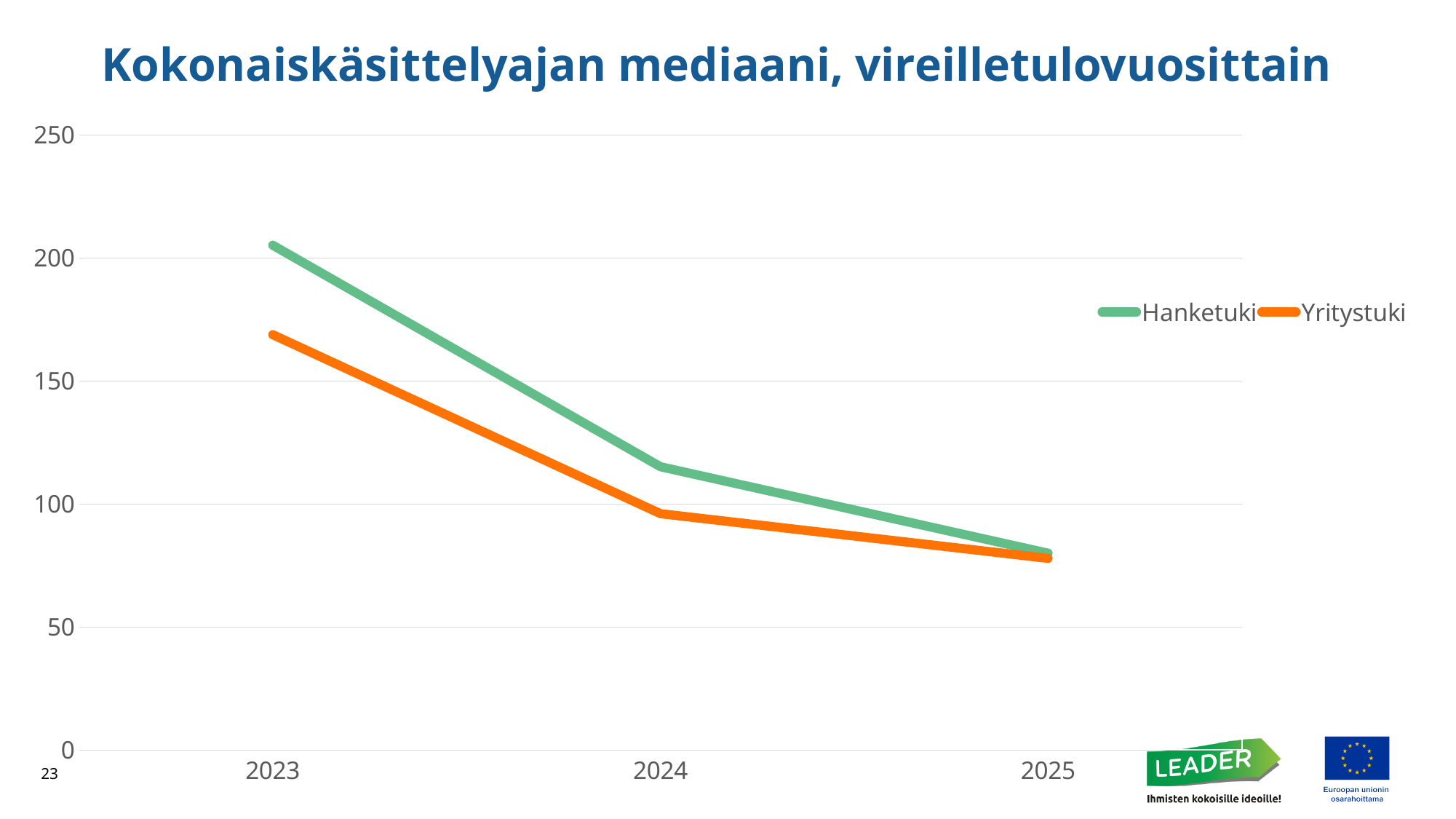
Is the value for Hanketuki in 2023 greater or less than 150? greater Is the value for Hanketuki in 2025 greater or less than 100? less Is the value for Yritystuki in 2023 greater or less than 150? greater Do the values for Yritystuki rise or fall from 2023 to 2025? fall Do the values for Hanketuki rise or fall from 2023 to 2025? fall What kind of chart is shown on the slide? line chart How many years are shown on the x axis? 3 In 2023, which series has the larger value, Hanketuki or Yritystuki? Hanketuki What is the title of the chart? Kokonaiskäsittelyajan mediaani, vireilletulovuosittain In which year is the value for Hanketuki highest? 2023 In which year is the value for Yritystuki lowest? 2025 How many series does the legend list? 2